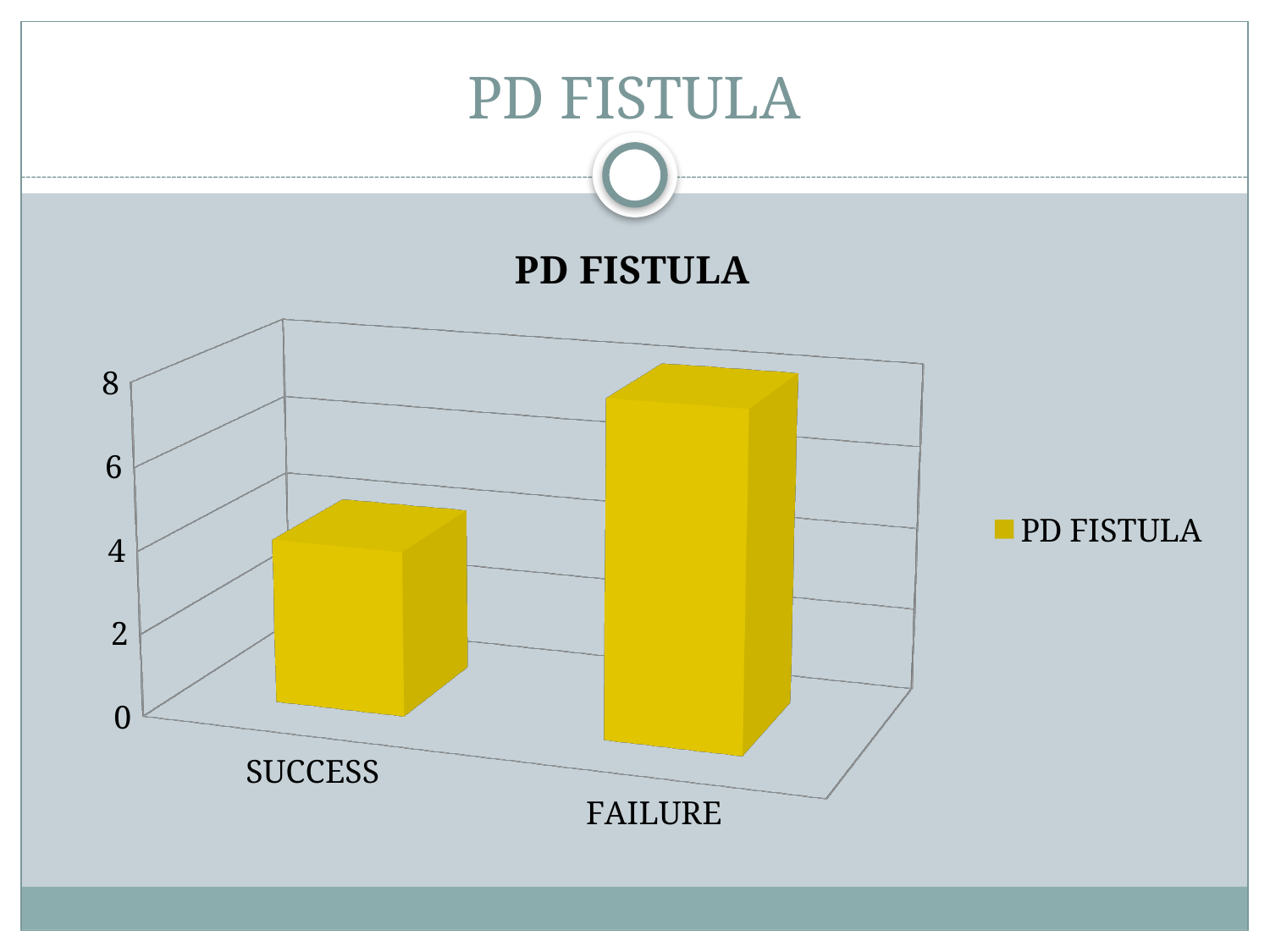
Is the value for SUCCESS greater or less than 2? greater What series name is shown in the chart's legend? PD FISTULA Is the value for SUCCESS greater or less than 6? less How many series does the chart's legend list? 1 Which is larger, the value for SUCCESS or the value for FAILURE? FAILURE Is the value for FAILURE greater or less than 6? greater Which category has the highest value in the chart? FAILURE How many categories are plotted on the x axis of the chart? 2 What kind of chart is shown on the slide? bar chart What is the title of the chart? PD FISTULA Which category has the lowest value in the chart? SUCCESS